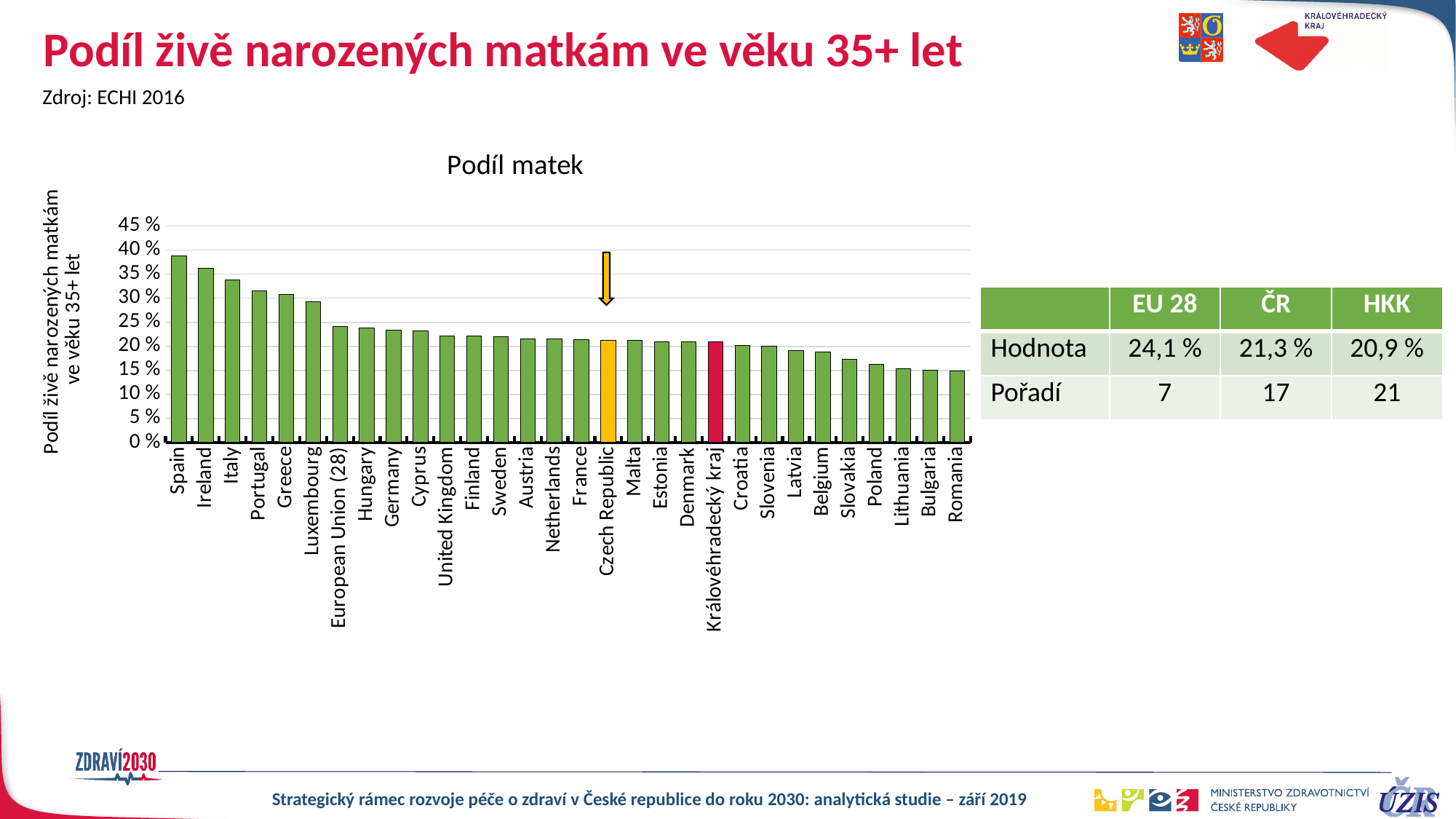
Is the value for Romania greater or less than 20 %? less What is the difference between the EU 28 value and the ČR value shown in the table? 2,8 % Is the value for Spain greater or less than 35 %? greater What kind of chart is shown on the slide? bar chart Is the value for Luxembourg greater or less than 25 %? greater How many bars (categories) are plotted in the chart? 30 According to the table on the slide, what is the value (Hodnota) for EU 28? 24,1 % According to the table on the slide, what is the value (Hodnota) for HKK? 20,9 % Which has the larger value, Italy or Portugal? Italy Do the values rise or fall moving from left to right along the x axis? fall Which category has the highest value in the chart? Spain What colour is the bar for Královéhradecký kraj? red